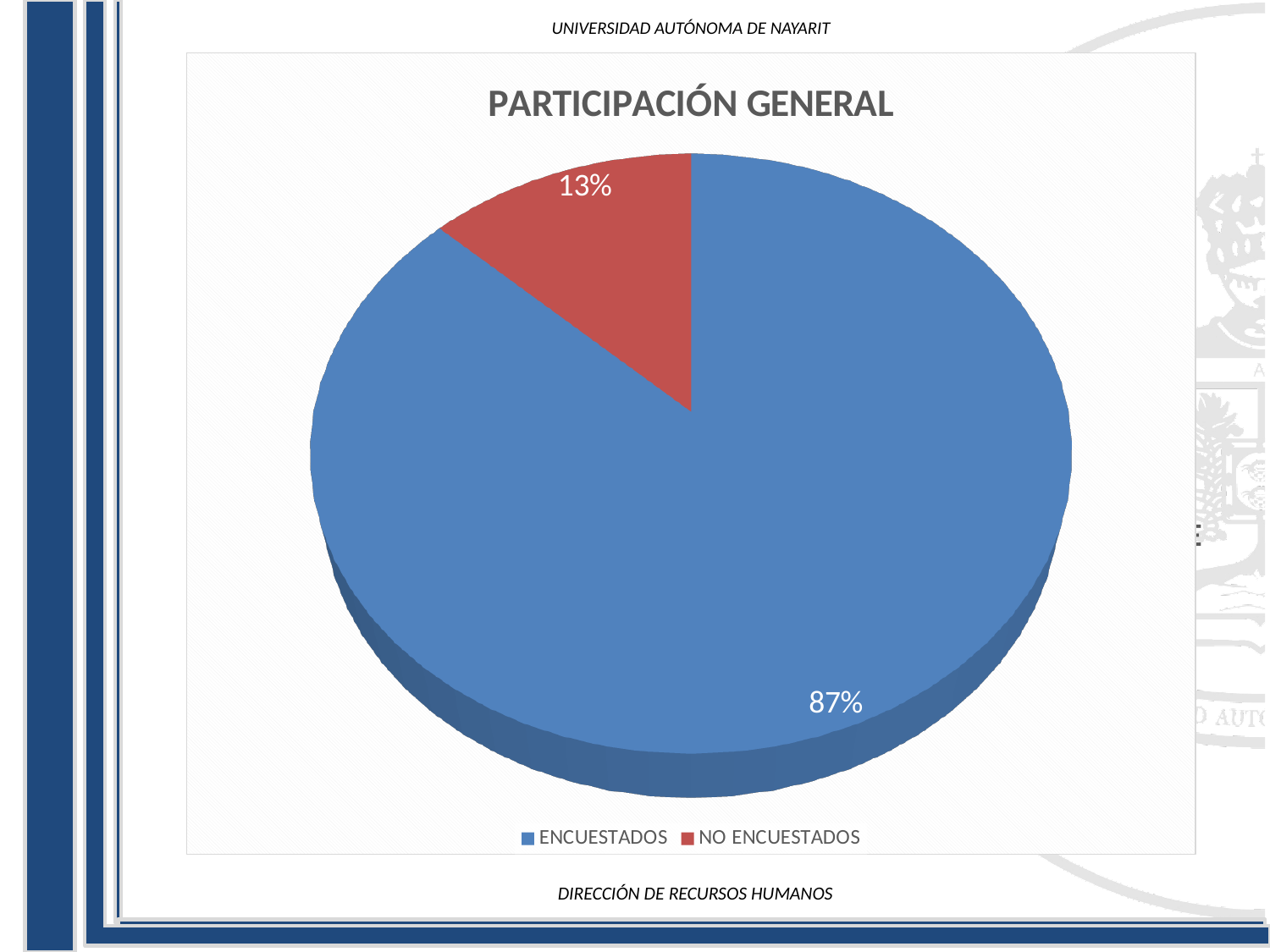
Is the share for NO ENCUESTADOS greater or less than 50%? less Which is larger, ENCUESTADOS or NO ENCUESTADOS? ENCUESTADOS Which slice is the smallest? NO ENCUESTADOS What colour is the NO ENCUESTADOS slice? red Which slice is the largest? ENCUESTADOS How many slices does the pie chart have? 2 What kind of chart is shown on the slide? pie chart How many entries does the legend list? 2 What is the title of the chart? PARTICIPACIÓN GENERAL What share of the pie does NO ENCUESTADOS represent? 13% What share of the pie does ENCUESTADOS represent? 87% What is the difference in percentage points between ENCUESTADOS and NO ENCUESTADOS? 74